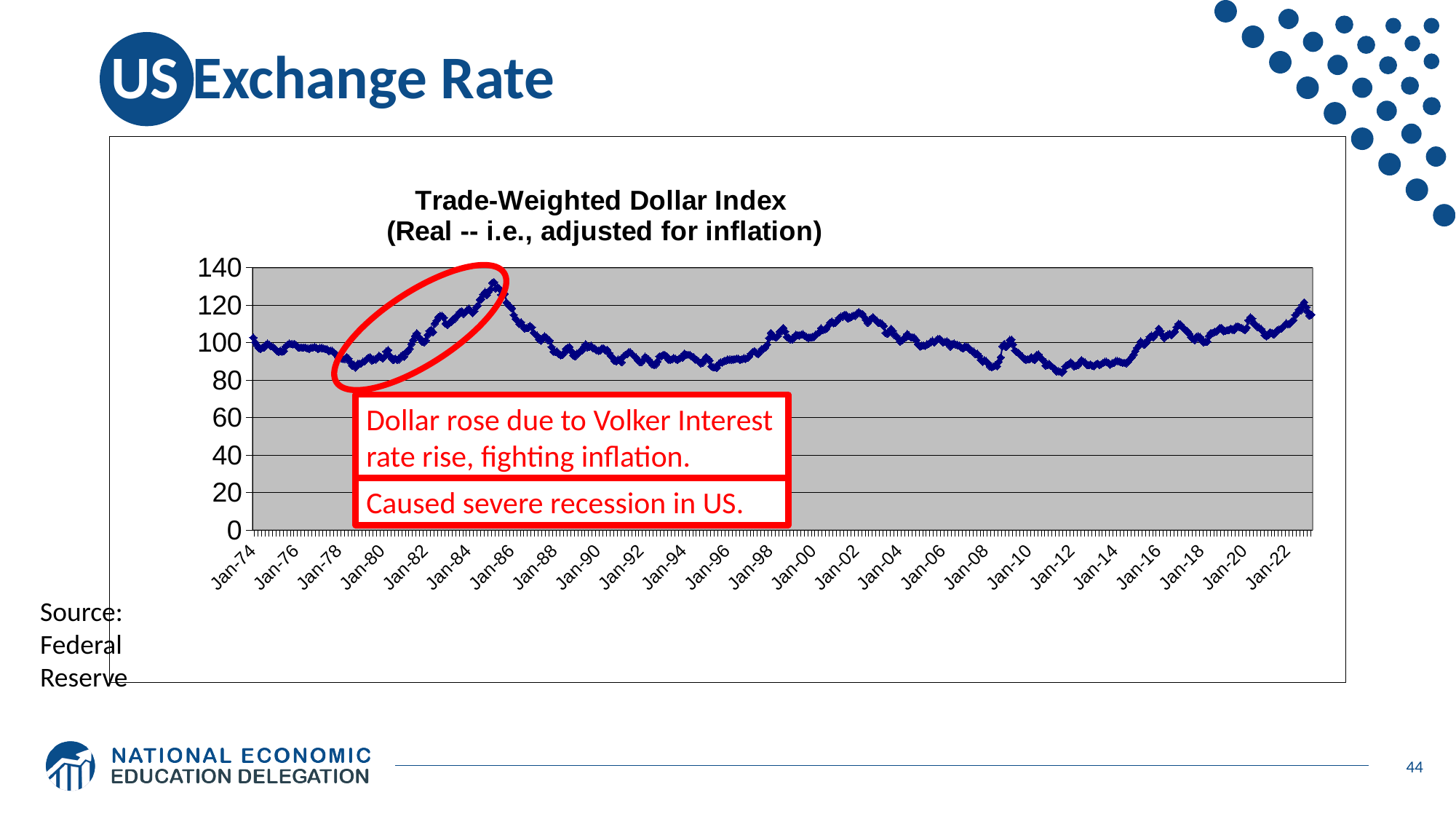
Is the value of the Trade-Weighted Dollar Index around Jan-78 greater or less than 100? less What kind of chart is shown on the slide? line chart Is the value of the Trade-Weighted Dollar Index at its peak around Jan-86 greater or less than 120? greater What is the title of the chart? Trade-Weighted Dollar Index (Real -- i.e., adjusted for inflation) Does the Trade-Weighted Dollar Index rise or fall between Jan-86 and Jan-88? fall Is the value of the Trade-Weighted Dollar Index around Jan-02 greater or less than 100? greater Does the Trade-Weighted Dollar Index rise or fall between Jan-80 and Jan-86? rise Around which x-axis label does the Trade-Weighted Dollar Index reach its highest value? Jan-86 How many year labels are shown on the x axis of the chart? 25 What is the highest value shown on the y axis of the chart? 140